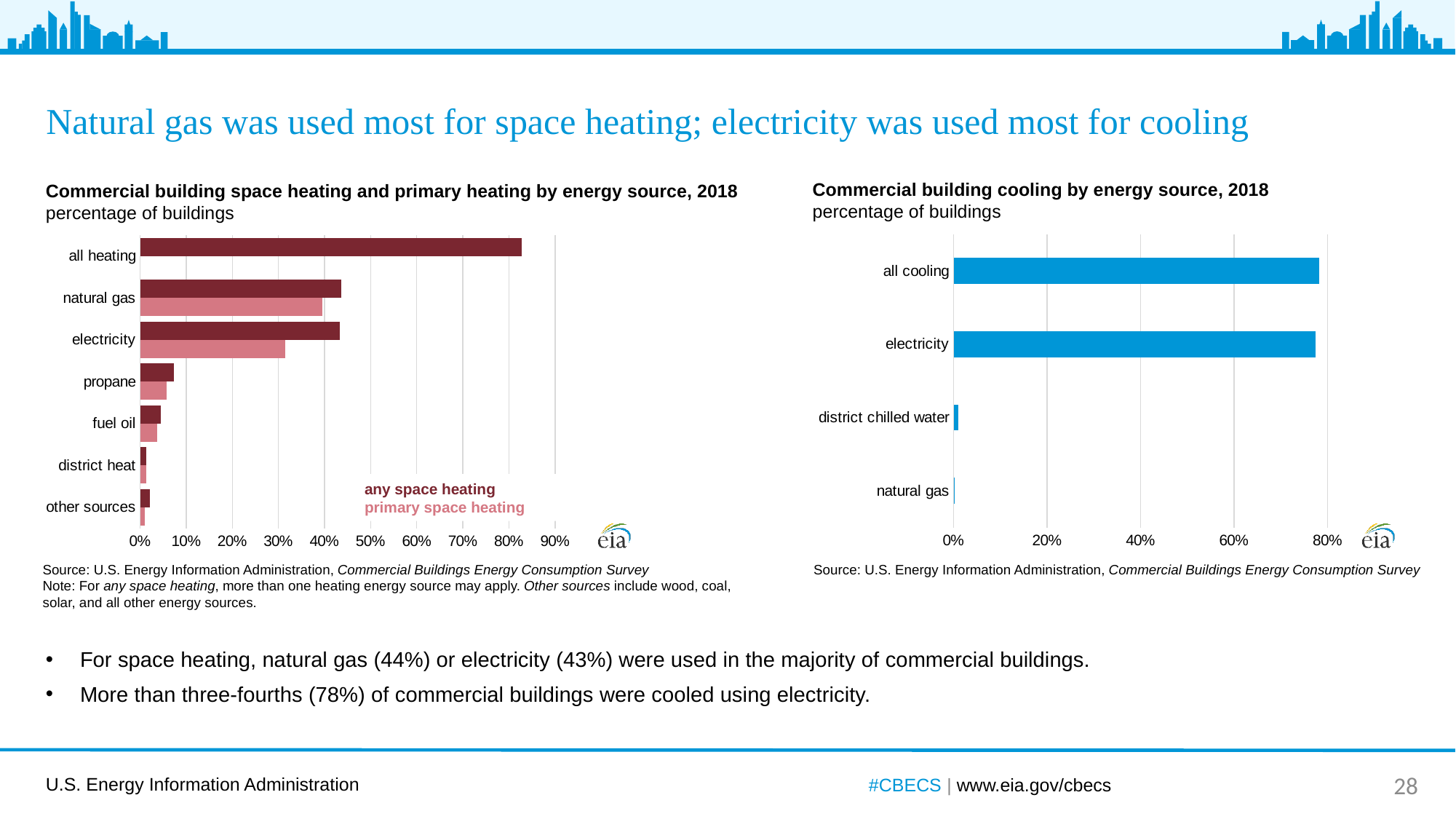
How many categories are shown on the 'Commercial building cooling by energy source, 2018' chart? 4 In the 'Commercial building space heating and primary heating by energy source, 2018' chart, which has the larger any space heating value, propane or fuel oil? propane In the 'Commercial building cooling by energy source, 2018' chart, is the value for electricity greater or less than 60%? greater In the 'Commercial building cooling by energy source, 2018' chart, which category has the lowest value? natural gas In the 'Commercial building space heating and primary heating by energy source, 2018' chart, which series is shown in dark red? any space heating What kind of chart is the 'Commercial building cooling by energy source, 2018' chart? bar chart How many series does the legend of the 'Commercial building space heating and primary heating by energy source, 2018' chart list? 2 How many energy source categories are shown on the 'Commercial building space heating and primary heating by energy source, 2018' chart? 7 What kind of chart is the 'Commercial building space heating and primary heating by energy source, 2018' chart? bar chart In the 'Commercial building space heating and primary heating by energy source, 2018' chart, which category has the highest value? all heating In the 'Commercial building space heating and primary heating by energy source, 2018' chart, is the value for all heating greater or less than 70%? greater In the 'Commercial building space heating and primary heating by energy source, 2018' chart, is the primary space heating value for electricity greater or less than 40%? less